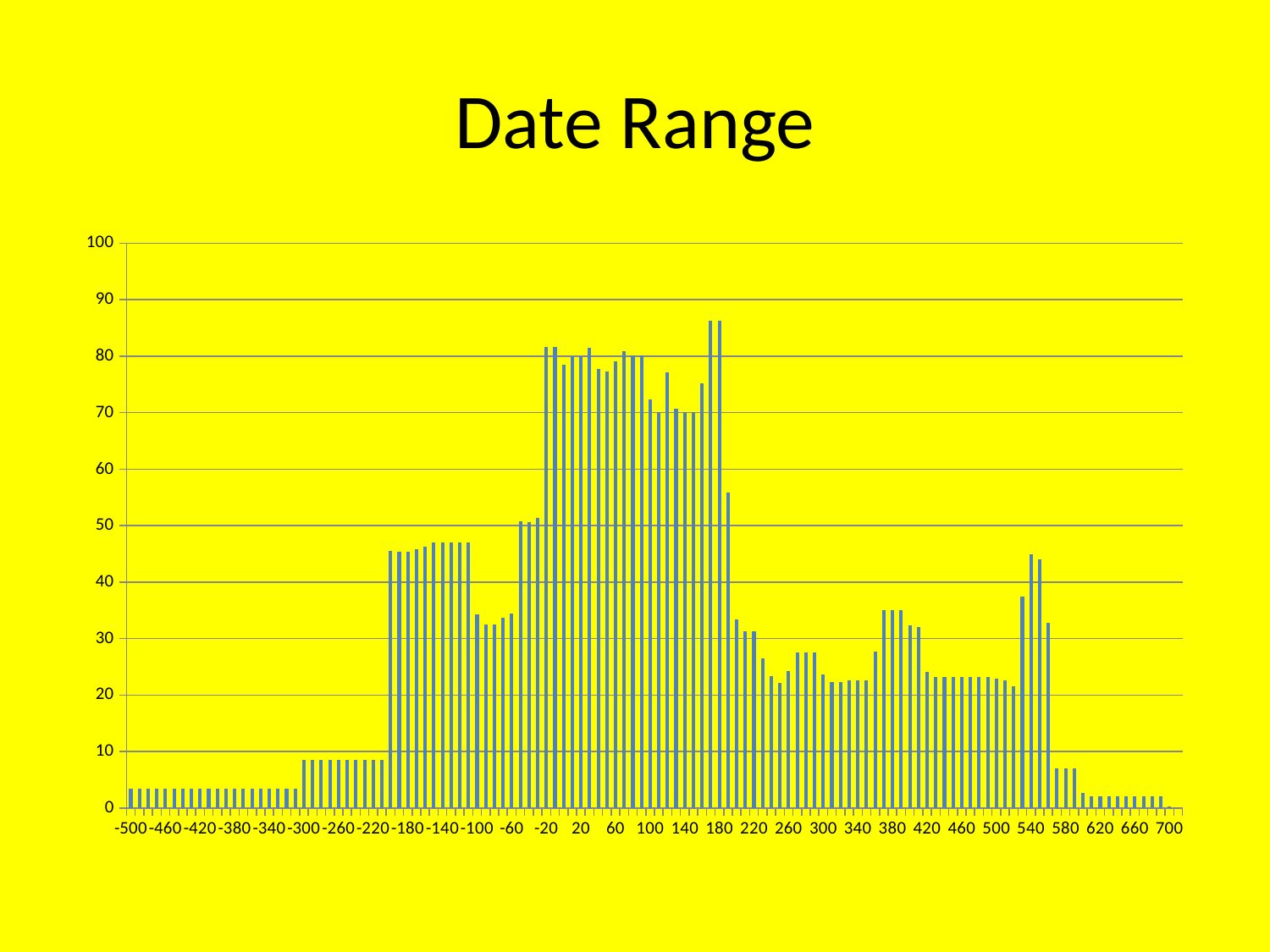
Is the value for 300 greater or less than 20? greater Is the value for -500 greater or less than 10? less Is the value for -20 greater or less than 70? greater Which has the larger value, -500 or 180? 180 What kind of chart is shown on the slide? bar chart What is the title of the chart? Date Range Do the values rise or fall along the x axis from 540 to 700? fall What colour are the bars in the chart? blue